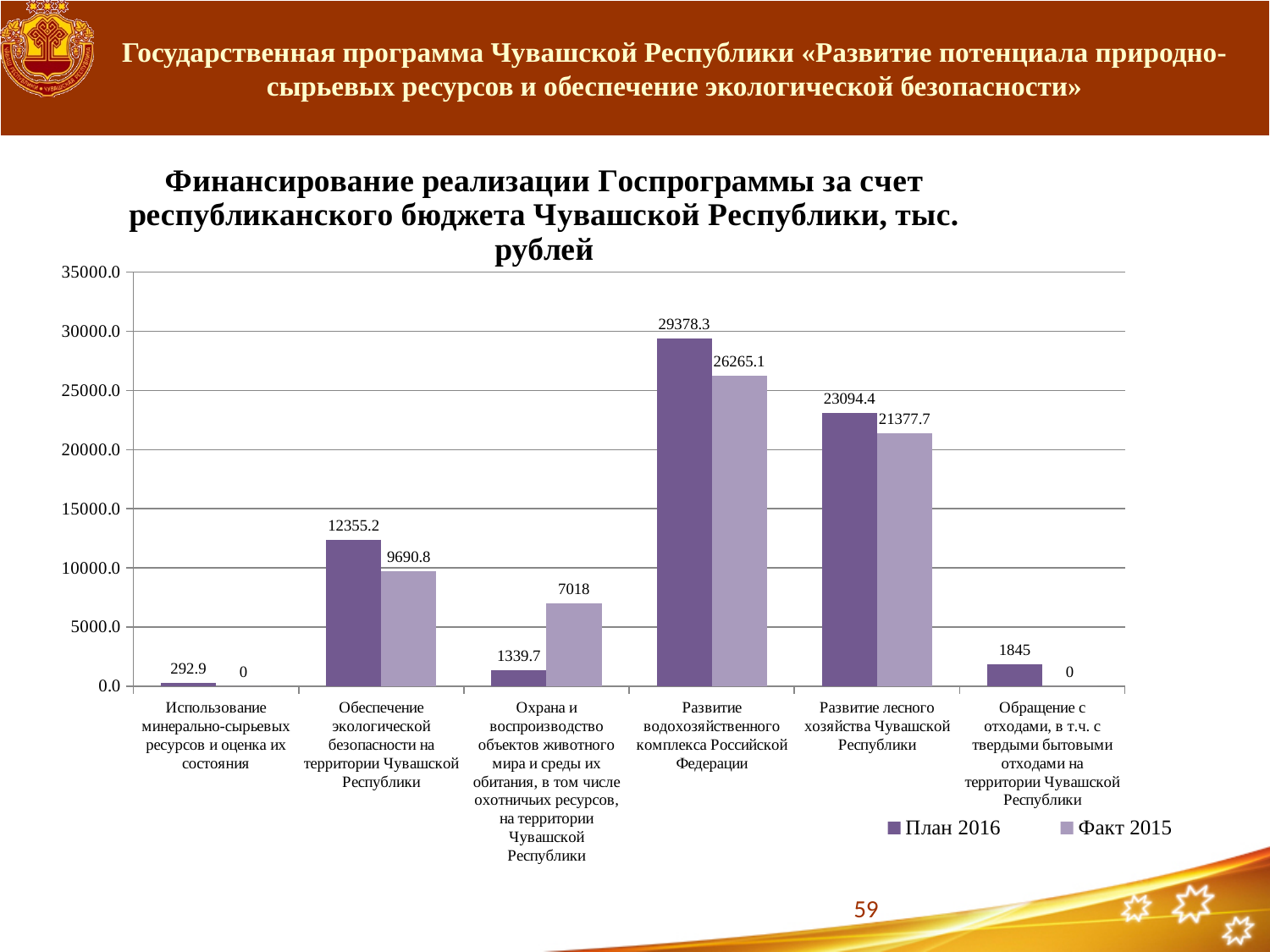
What is the Факт 2015 value for Охрана и воспроизводство объектов животного мира и среды их обитания? 7018 What kind of chart is shown on the slide? bar chart What is the План 2016 value for Обращение с отходами, в т.ч. с твердыми бытовыми отходами? 1845 How many series does the legend list? 2 For Развитие лесного хозяйства Чувашской Республики, which is larger: План 2016 or Факт 2015? План 2016 Is the Факт 2015 value for Развитие лесного хозяйства Чувашской Республики greater or less than 20000.0? greater What is the difference between the Факт 2015 and План 2016 values for Охрана и воспроизводство объектов животного мира и среды их обитания? 5678.3 What is the План 2016 value for Развитие водохозяйственного комплекса Российской Федерации? 29378.3 What is the difference between the План 2016 and Факт 2015 values for Развитие водохозяйственного комплекса Российской Федерации? 3113.2 Which category has the lowest План 2016 value? Использование минерально-сырьевых ресурсов и оценка их состояния Which category has the highest План 2016 value? Развитие водохозяйственного комплекса Российской Федерации What is the Факт 2015 value for Обеспечение экологической безопасности на территории Чувашской Республики? 9690.8